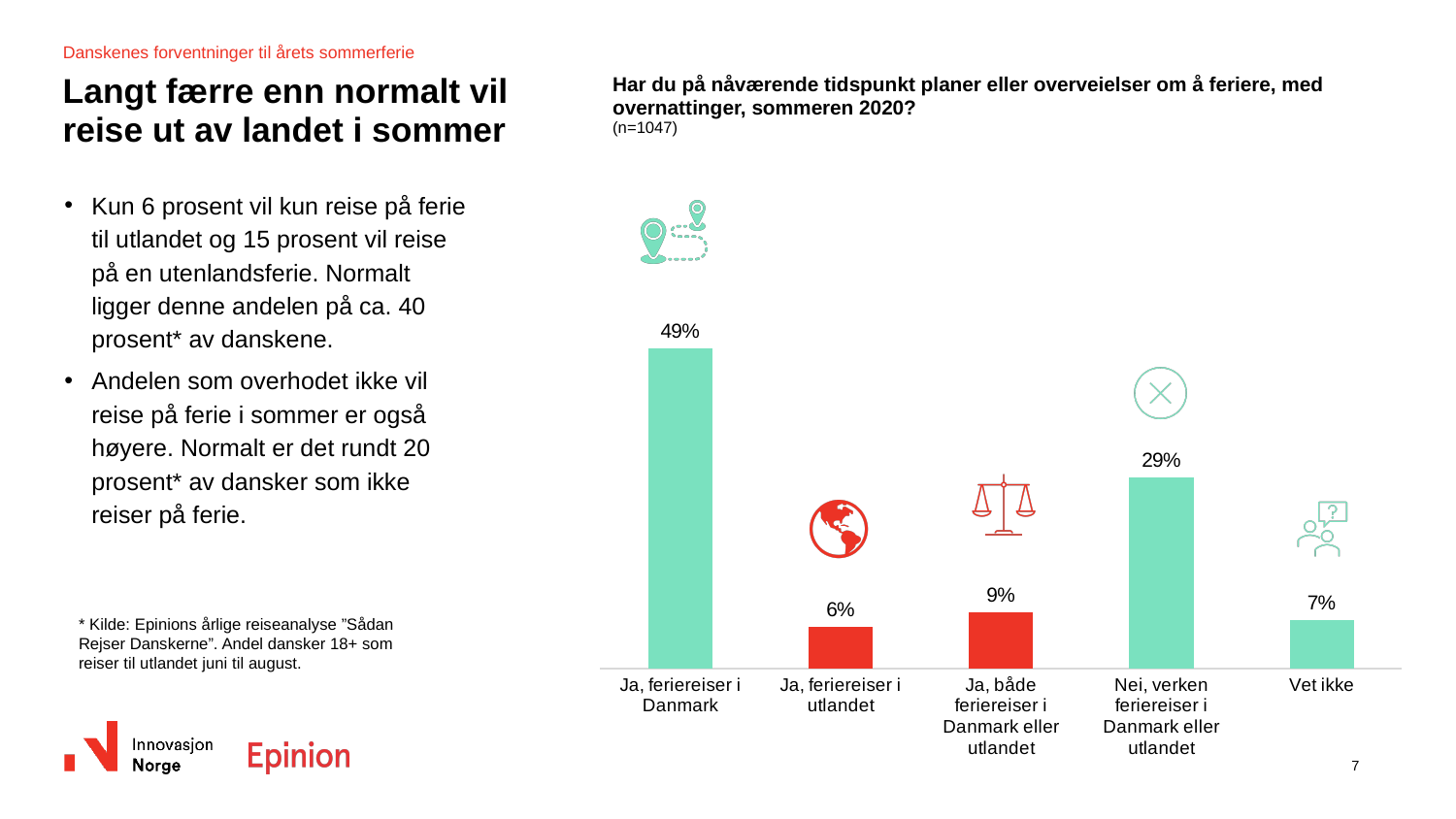
What is the sample size (n) stated for the chart? 1047 What percentage answered "Vet ikke"? 7% What is the value for "Nei, verken feriereiser i Danmark eller utlandet"? 29% What is the value for "Ja, både feriereiser i Danmark eller utlandet"? 9% Which is larger: "Ja, både feriereiser i Danmark eller utlandet" or "Vet ikke"? Ja, både feriereiser i Danmark eller utlandet Which category has the highest value? Ja, feriereiser i Danmark What is the difference between "Ja, feriereiser i Danmark" and "Nei, verken feriereiser i Danmark eller utlandet"? 20 percentage points What is the combined value of "Ja, feriereiser i utlandet" and "Ja, både feriereiser i Danmark eller utlandet"? 15% How many categories are shown in the chart? 5 Which category has the lowest value? Ja, feriereiser i utlandet What percentage of respondents answered "Ja, feriereiser i Danmark"? 49% What type of chart is shown on the slide? Bar chart